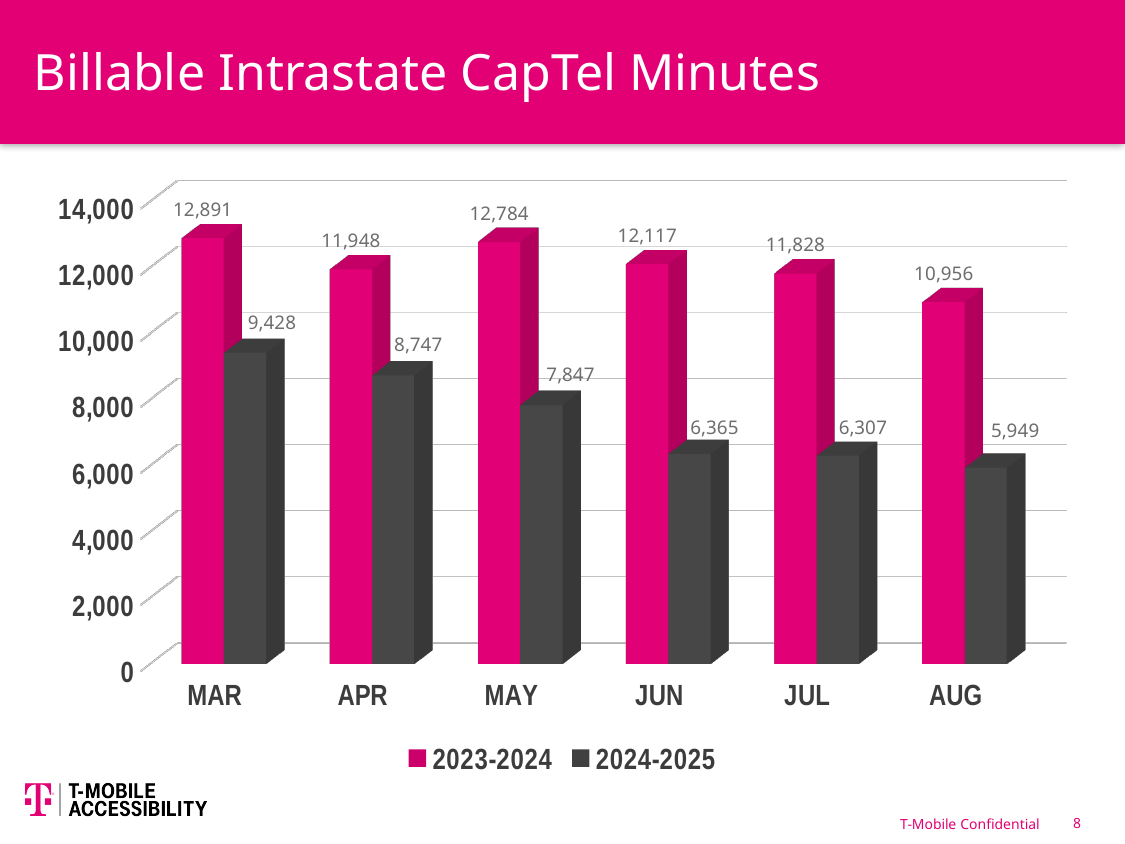
Do the 2024-2025 values rise or fall from MAR to AUG? fall How many months are shown on the x axis? 6 What is the difference between the 2023-2024 and 2024-2025 values for MAY? 4,937 Which month has the highest value in the 2024-2025 series? MAR What is the value for MAR in the 2023-2024 series? 12,891 What is the value for AUG in the 2023-2024 series? 10,956 How many series does the legend list? 2 Is the 2024-2025 value for AUG greater or less than 6,000? less What kind of chart is shown on the slide? bar chart Which month has the lowest value in the 2023-2024 series? AUG Which is larger: the 2024-2025 value for APR or the 2024-2025 value for JUL? APR What is the value for JUN in the 2024-2025 series? 6,365